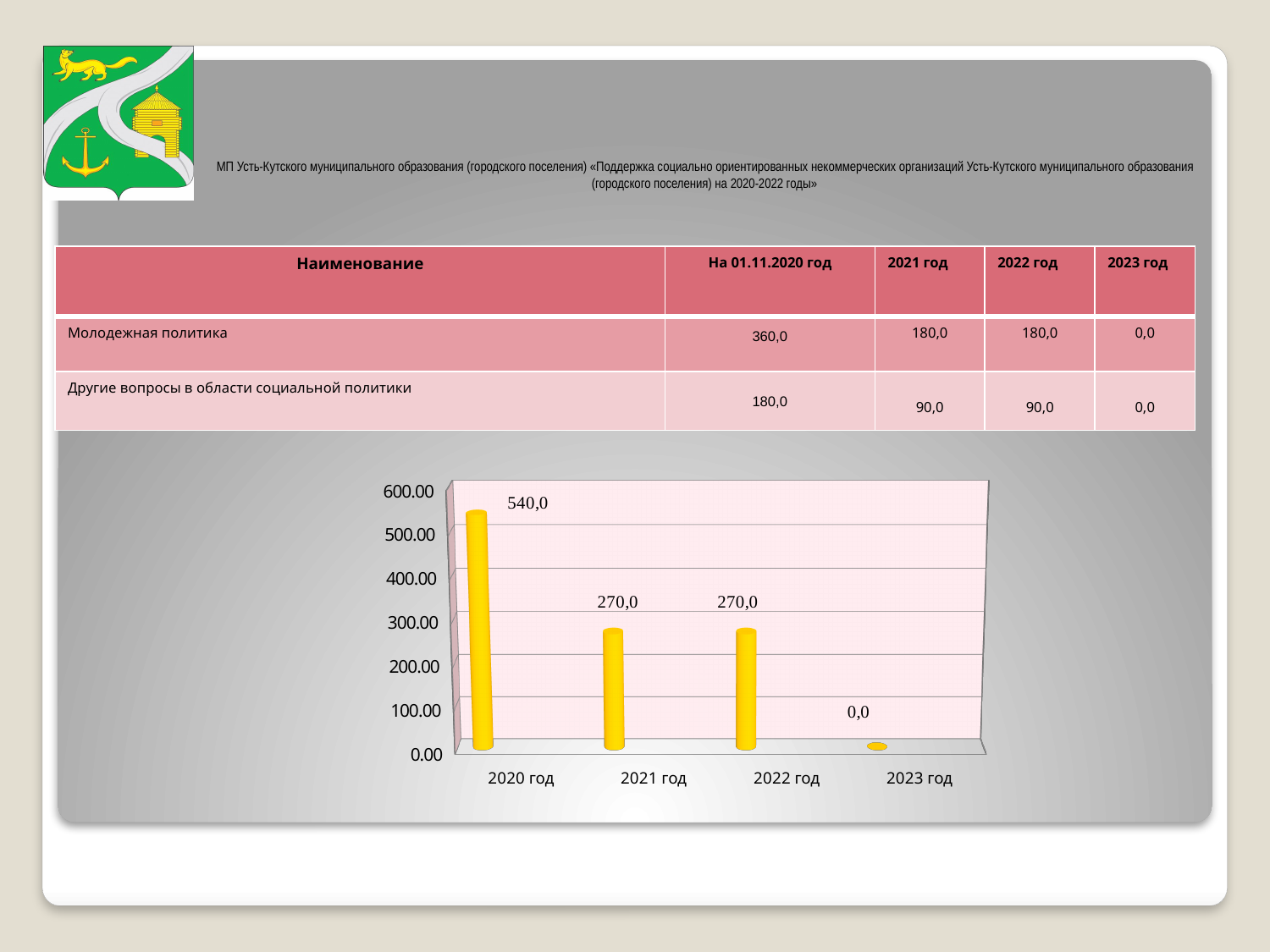
What is the difference between the values for 2020 год and 2021 год in the chart? 270,0 Is the value for 2021 год in the chart greater or less than 300.00? less Which is larger in the chart, the value for 2020 год or the value for 2022 год? 2020 год How many years are shown on the x axis of the chart? 4 Which year has the lowest value in the chart? 2023 год Which year has the highest value in the chart? 2020 год What is the value for 2021 год in the chart? 270,0 Do the values in the chart rise or fall from 2020 год to 2023 год? fall What kind of chart is shown on the slide? bar chart What is the value for 2023 год in the chart? 0,0 What is the value for 2020 год in the chart? 540,0 What colour are the bars in the chart? yellow